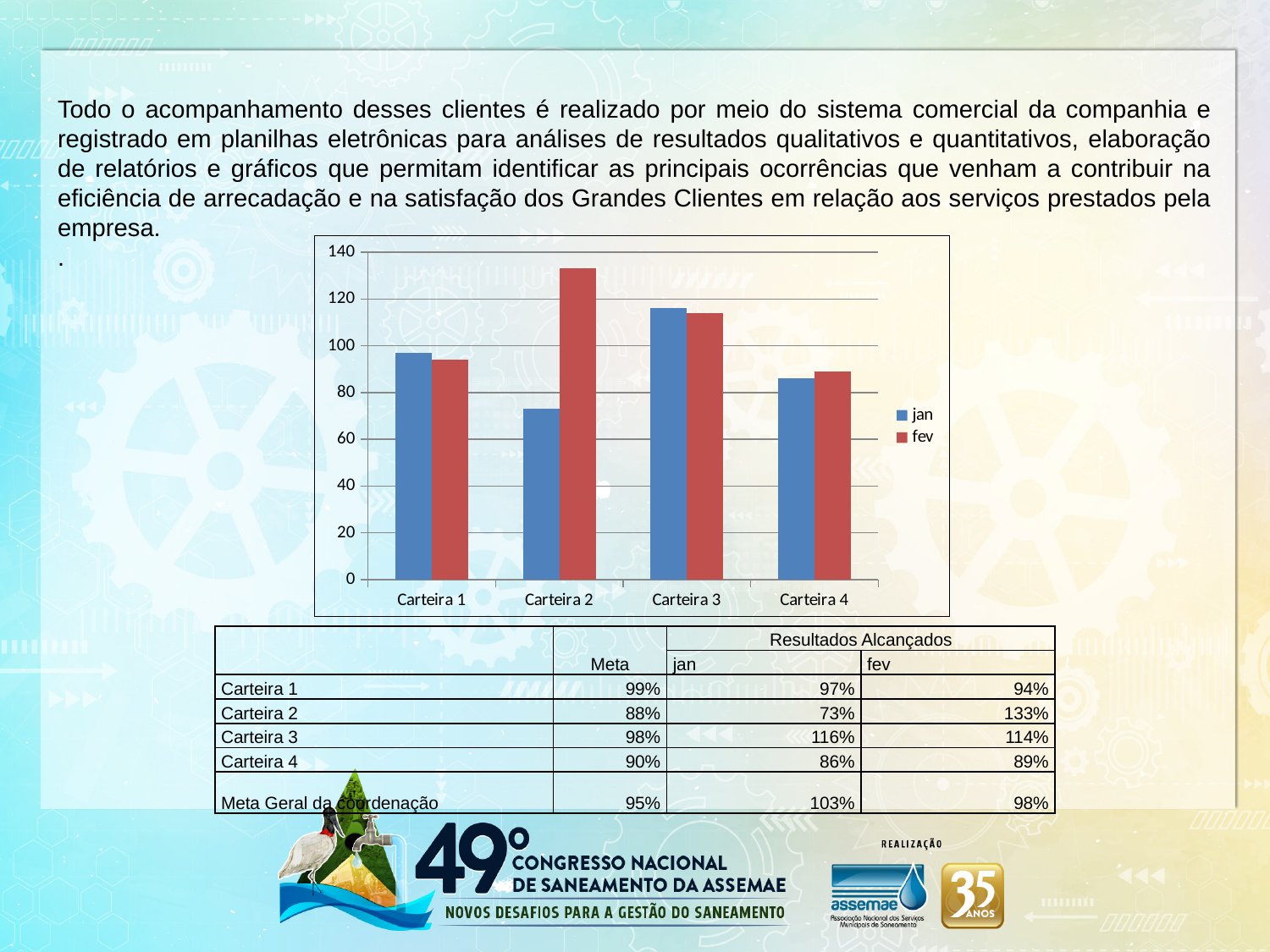
How many series does the chart legend list? 2 What kind of chart is shown on the slide? bar chart For Carteira 2, which is larger, the jan bar or the fev bar? fev How many categories are shown on the x axis of the chart? 4 Is the jan value for Carteira 4 greater or less than 100? less Is the jan value for Carteira 2 greater or less than 80? less Is the fev value for Carteira 2 greater or less than 120? greater According to the table below the chart, what is the jan result for Carteira 3? 116% Which category has the lowest jan bar in the chart? Carteira 2 Which category has the highest fev bar in the chart? Carteira 2 What are the two legend entries of the chart? jan and fev Which category has the highest jan bar in the chart? Carteira 3